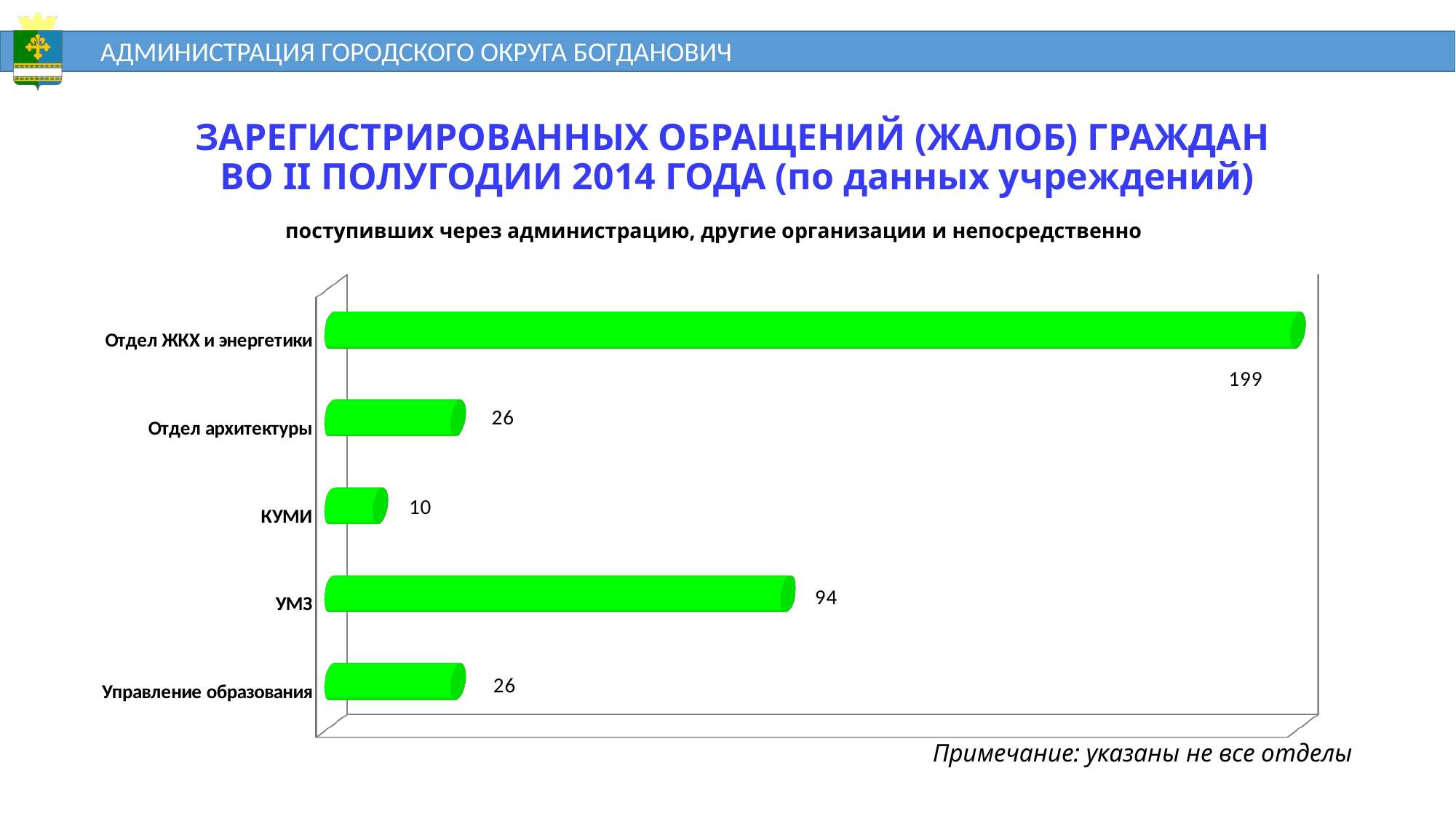
What kind of chart is shown on the slide? Bar chart What is the difference between the values for УМЗ and КУМИ? 84 What is the difference between the values for Отдел ЖКХ и энергетики and УМЗ? 105 What is the value for Управление образования? 26 What is the value for КУМИ? 10 Which category has the highest value? Отдел ЖКХ и энергетики Which is larger, the value for УМЗ or the value for Отдел архитектуры? УМЗ How many categories are shown in the chart? 5 Which category has the lowest value? КУМИ What is the value for Отдел архитектуры? 26 What is the value for УМЗ? 94 What is the value for Отдел ЖКХ и энергетики? 199